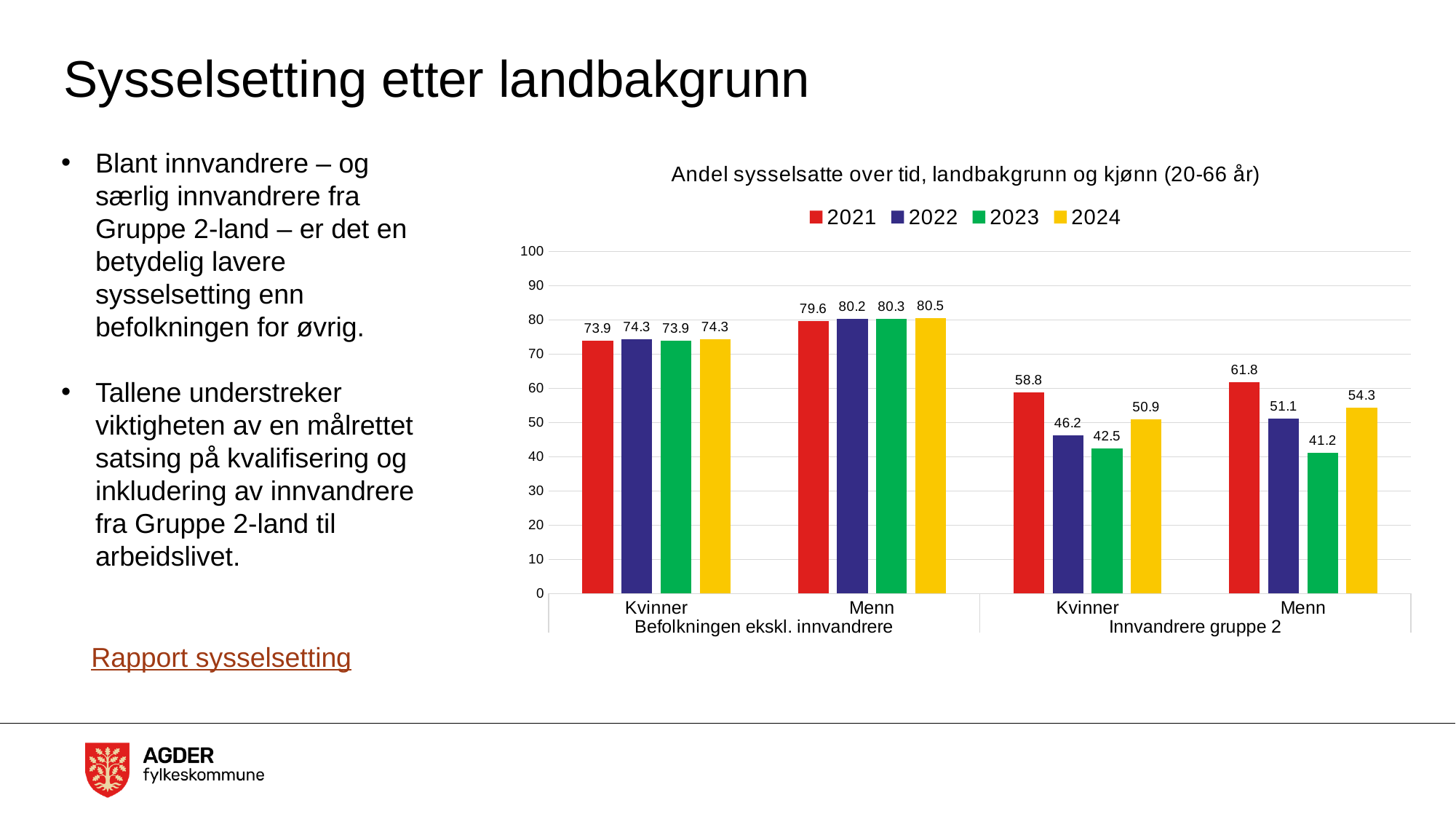
What is the difference between the 2021 and 2023 values for Kvinner in Innvandrere gruppe 2? 16.3 Which year has the highest value for Kvinner in Innvandrere gruppe 2? 2021 What kind of chart is shown on the slide? Bar chart How many series does the legend list? 4 Which year has the lowest value for Menn in Innvandrere gruppe 2? 2023 What is the title of the chart? Andel sysselsatte over tid, landbakgrunn og kjønn (20-66 år) What is the 2023 value for Kvinner in Innvandrere gruppe 2? 42.5 What is the 2021 value for Menn in Innvandrere gruppe 2? 61.8 Which is larger: the 2024 value for Kvinner in Innvandrere gruppe 2 or the 2022 value for Menn in Innvandrere gruppe 2? 2022 value for Menn in Innvandrere gruppe 2 Do the values for Menn in Befolkningen ekskl. innvandrere rise or fall from 2021 to 2024? Rise Which colour represents 2024 in the chart? Yellow What is the 2024 value for Menn in Befolkningen ekskl. innvandrere? 80.5